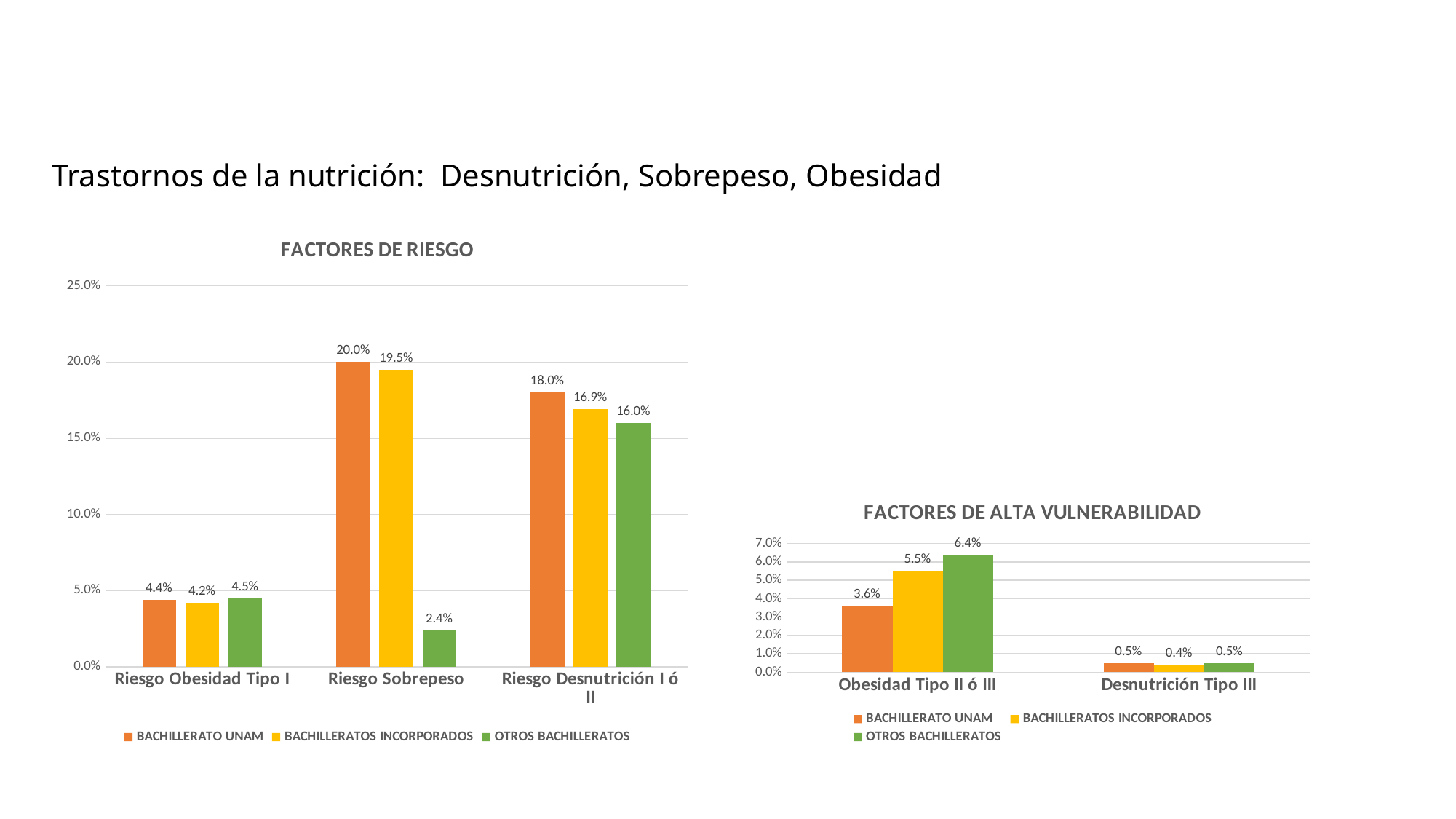
In the FACTORES DE ALTA VULNERABILIDAD chart, which is larger for Obesidad Tipo II ó III: BACHILLERATO UNAM or BACHILLERATOS INCORPORADOS? BACHILLERATOS INCORPORADOS How many categories are shown on the x axis of the FACTORES DE RIESGO chart? 3 In the FACTORES DE RIESGO chart, what is the value for OTROS BACHILLERATOS in Riesgo Sobrepeso? 2.4% What kind of chart is the FACTORES DE ALTA VULNERABILIDAD chart? Bar chart In the FACTORES DE RIESGO chart, is the BACHILLERATOS INCORPORADOS value for Riesgo Sobrepeso greater or less than 15.0%? greater In the FACTORES DE RIESGO chart, what is the value for BACHILLERATO UNAM in Riesgo Sobrepeso? 20.0% In the FACTORES DE RIESGO chart, what is the value for BACHILLERATOS INCORPORADOS in Riesgo Desnutrición I ó II? 16.9% In the FACTORES DE RIESGO chart, which series has the highest value for Riesgo Obesidad Tipo I? OTROS BACHILLERATOS How many series does the legend of the FACTORES DE ALTA VULNERABILIDAD chart list? 3 In the FACTORES DE ALTA VULNERABILIDAD chart, what is the value for OTROS BACHILLERATOS in Obesidad Tipo II ó III? 6.4% In the FACTORES DE RIESGO chart, what is the difference between BACHILLERATO UNAM and OTROS BACHILLERATOS in Riesgo Desnutrición I ó II? 2.0% In the FACTORES DE ALTA VULNERABILIDAD chart, which series has the lowest value for Desnutrición Tipo III? BACHILLERATOS INCORPORADOS